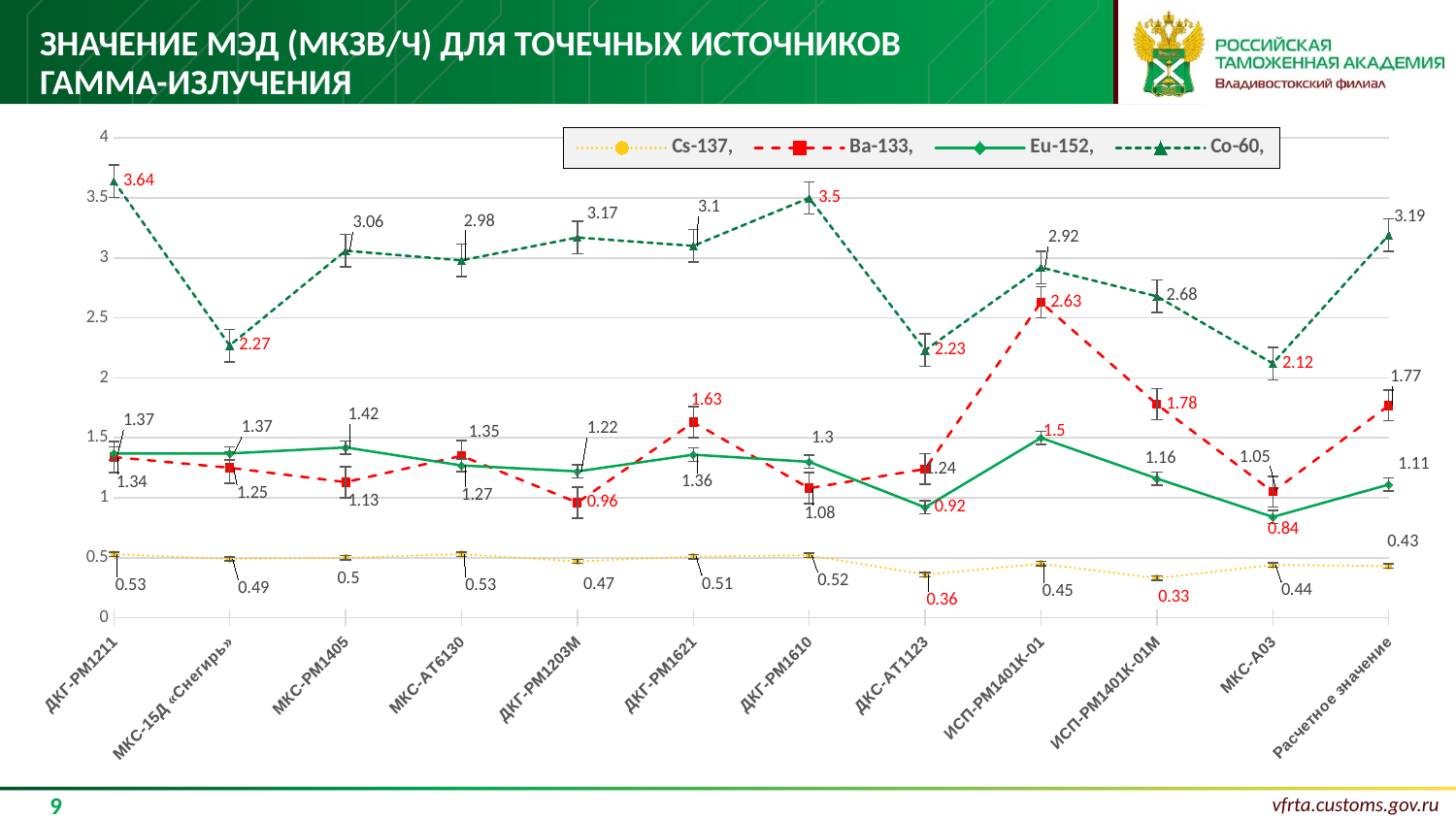
How many categories are shown along the x axis? 12 How many series does the legend list? 4 Is the Co-60 value for ДКГ-РМ1610 greater or less than 3? greater For which category is the Co-60 value lowest? МКС-А03 What is the Co-60 value for Расчетное значение? 3.19 For which category is the Cs-137 value lowest? ИСП-РМ1401К-01М What is the Co-60 value for ДКГ-РМ1211? 3.64 What type of chart is shown on the slide? Line chart Which series has the larger value for ДКГ-РМ1621, Co-60 or Ba-133? Co-60 What is the difference between the Co-60 values for ДКГ-РМ1211 and МКС-15Д «Снегирь»? 1.37 For which category is the Ba-133 value highest? ИСП-РМ1401К-01 What is the Cs-137 value for ДКС-АТ1123? 0.36